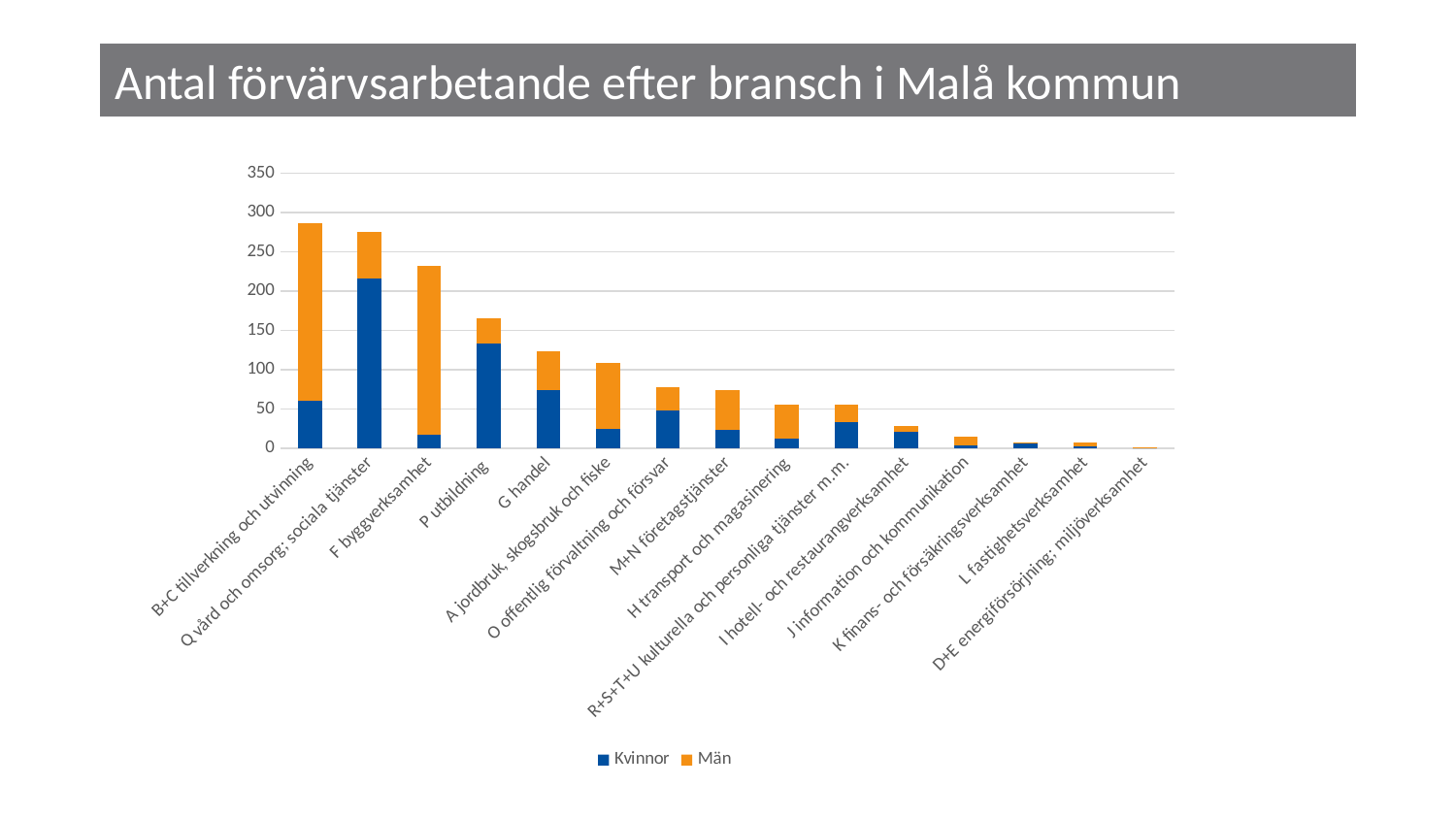
Which is larger, the Kvinnor value for P utbildning or the Kvinnor value for G handel? P utbildning Is the total value for O offentlig förvaltning och försvar greater or less than 100? less Which category has the lowest total bar? D+E energiförsörjning; miljöverksamhet Is the total value for B+C tillverkning och utvinning greater or less than 250? greater How many categories (branscher) are shown on the x axis? 15 Do the total bar heights rise or fall from left to right along the x axis? fall What kind of chart is shown on the slide? stacked bar chart Which category has the highest Kvinnor value? Q vård och omsorg; sociala tjänster Is the Kvinnor value for Q vård och omsorg; sociala tjänster greater or less than 200? greater How many series does the legend list? 2 What is the title of the chart? Antal förvärvsarbetande efter bransch i Malå kommun